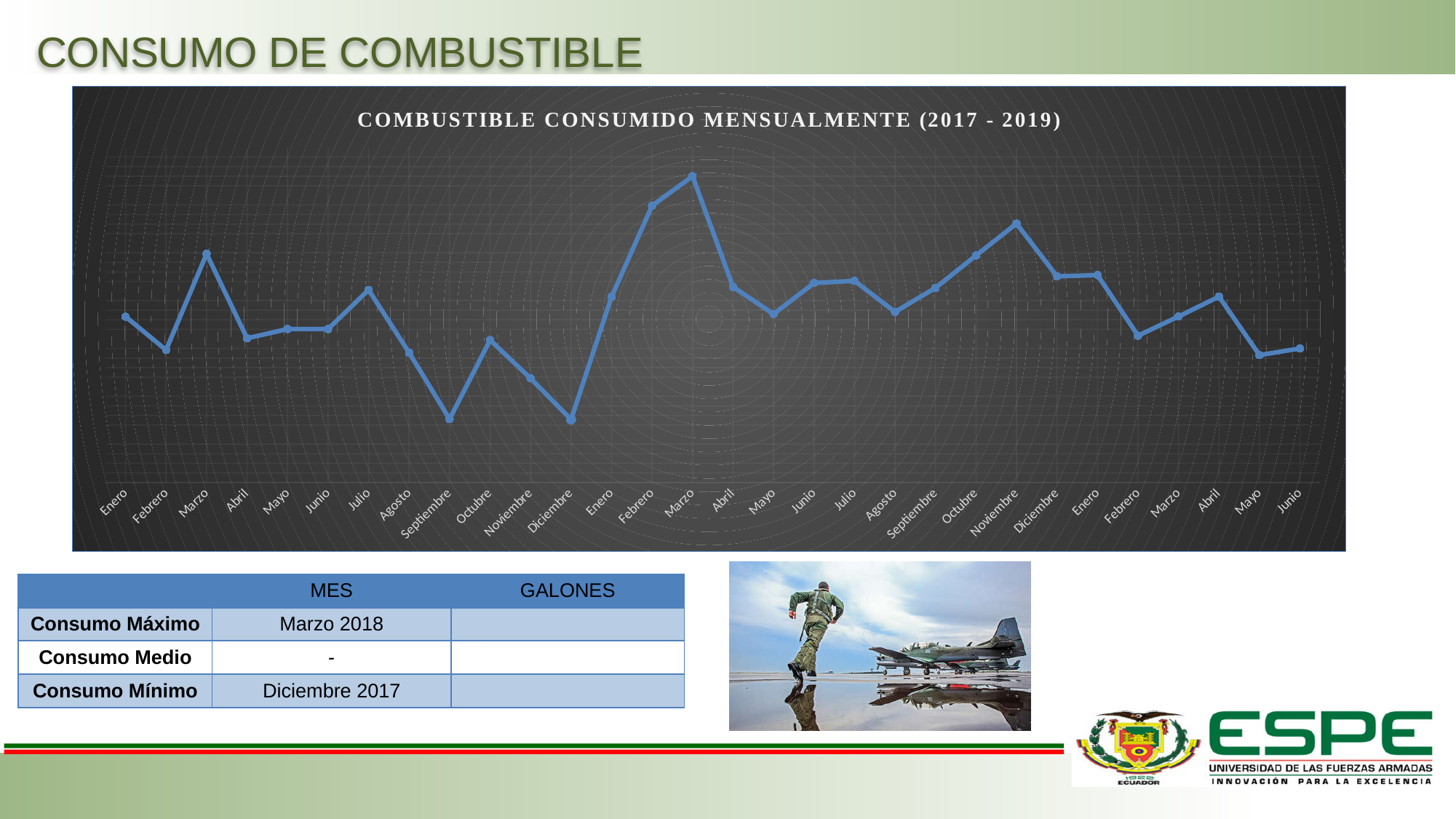
According to the table below the chart, which month is listed as the minimum consumption (Consumo Mínimo)? Diciembre 2017 Which is higher, the value for Marzo 2017 or Febrero 2017? Marzo 2017 Which month has the highest fuel consumption on the chart? Marzo 2018 Does the line rise or fall from Diciembre 2017 to Marzo 2018? rises What is the title of the chart? COMBUSTIBLE CONSUMIDO MENSUALMENTE (2017 - 2019) How many monthly data points are plotted on the chart? 30 Which is higher, the value for Noviembre 2018 or Diciembre 2018? Noviembre 2018 Does the line rise or fall from Marzo 2018 to Abril 2018? falls What kind of chart is shown on the slide? line chart How many lines (series) are plotted on the chart? 1 Which is higher, the value for Septiembre 2017 or Octubre 2017? Octubre 2017